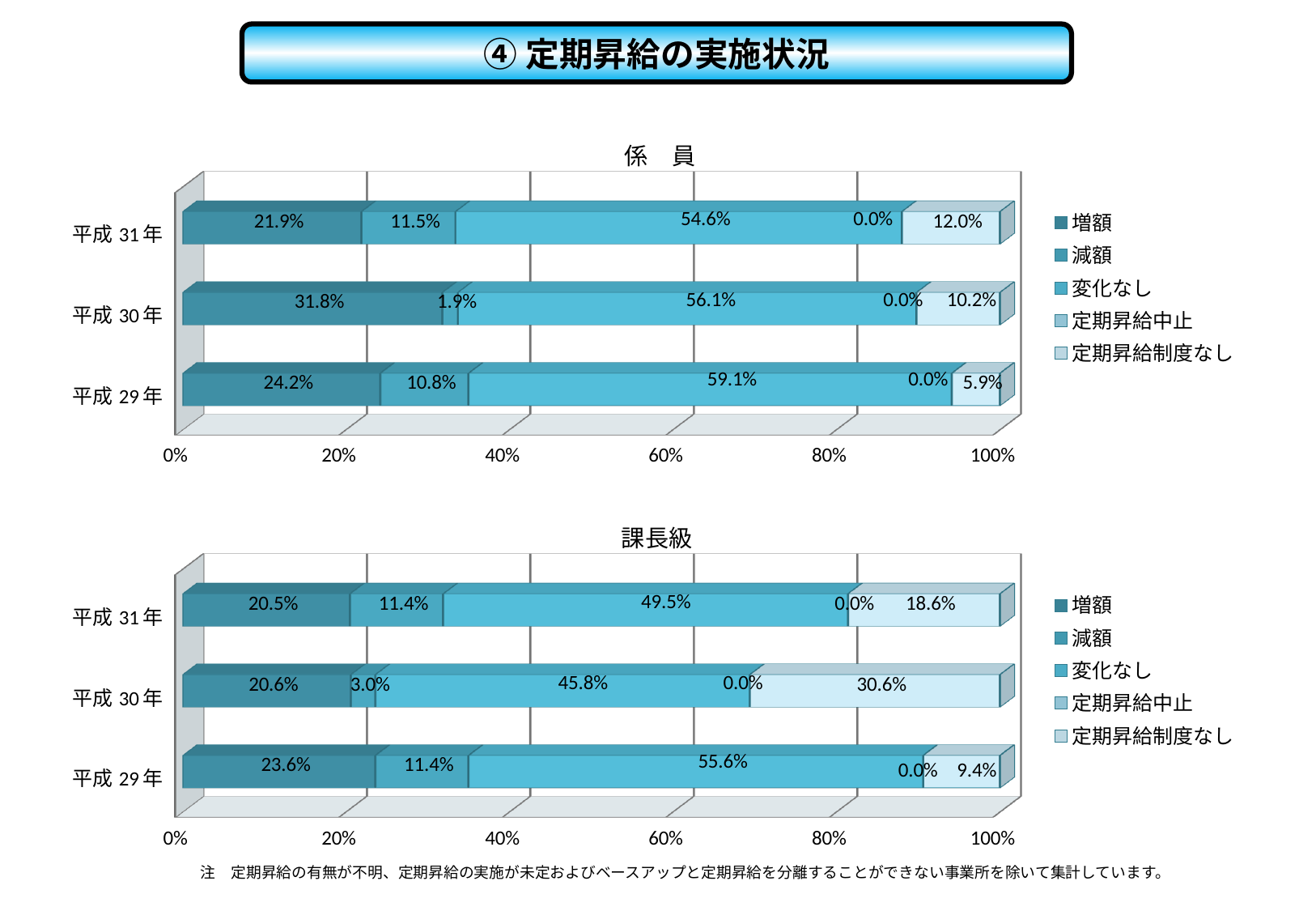
In the 係員 chart, what is the difference between the 増額 values for 平成 30 年 and 平成 31 年? 9.9% How many years are shown in the 課長級 chart? 3 In the 課長級 chart, which is larger: 増額 for 平成 29 年 or 増額 for 平成 31 年? 平成 29 年 In the 係員 chart, what is the value of 定期昇給中止 for 平成 29 年? 0.0% In the 係員 chart, what is the value of 変化なし for 平成 31 年? 54.6% How many series does the legend of the 係員 chart list? 5 In the 係員 chart, which year has the highest value for 定期昇給制度なし? 平成 31 年 In the 課長級 chart, which year has the lowest value for 変化なし? 平成 30 年 In the 課長級 chart, what is the value of 減額 for 平成 29 年? 11.4% What kind of chart is the 課長級 chart? Stacked bar chart In the 課長級 chart, what is the value of 定期昇給制度なし for 平成 30 年? 30.6% In the 係員 chart, what is the value of 増額 for 平成 30 年? 31.8%